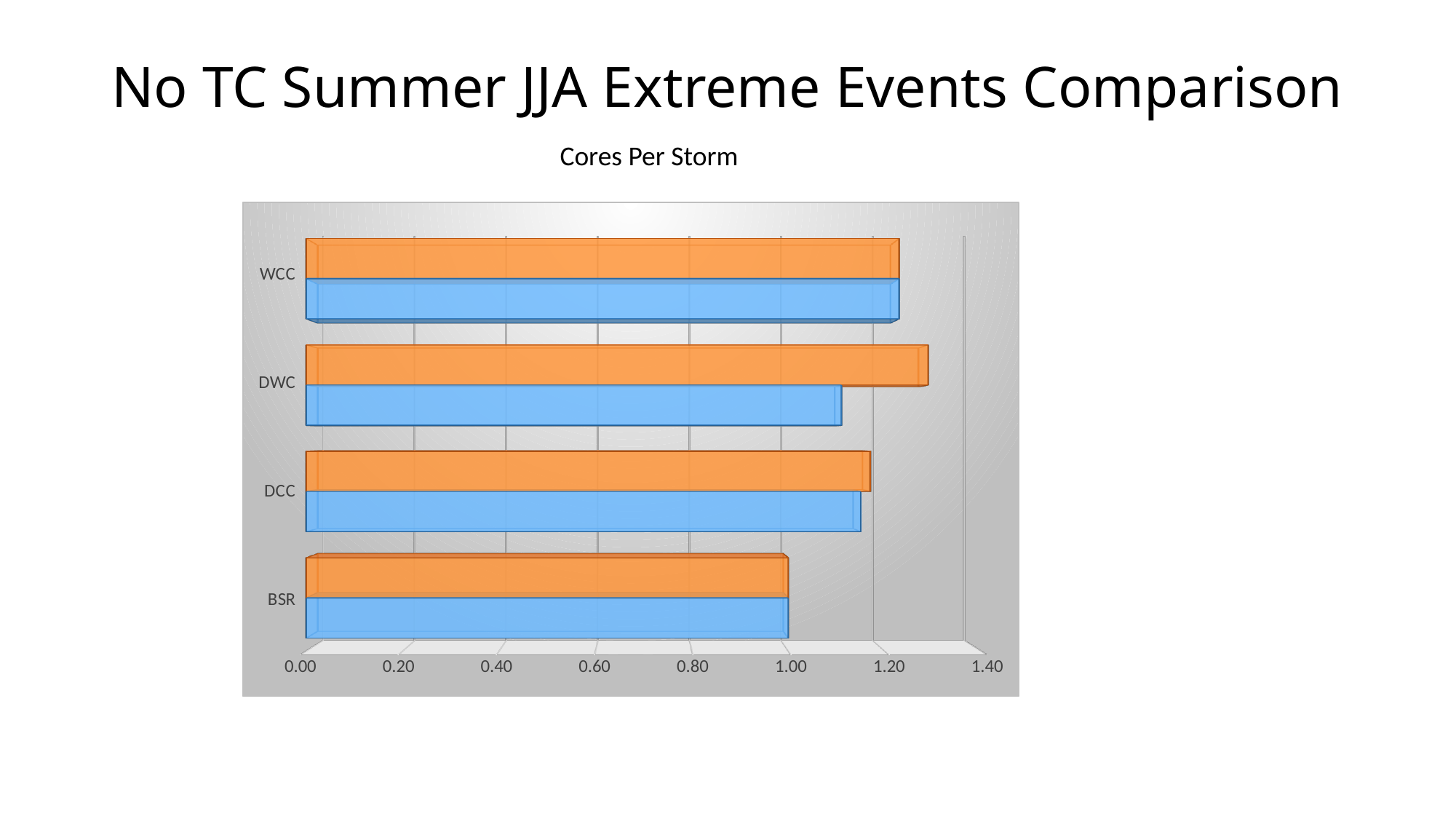
How many categories are shown on the chart? 4 What kind of chart is shown on the slide? bar chart How many data series are plotted in the chart? 2 Which category has the longest blue bar? WCC For DWC, which bar is longer, the orange one or the blue one? orange Is the blue bar for DWC greater or less than 1.20? less What is the title of the chart? Cores Per Storm Is the blue bar for DCC greater or less than 1.00? greater Which category has the longest orange bar? DWC Which category has the shortest orange bar? BSR Is the orange bar for BSR greater or less than 1.20? less